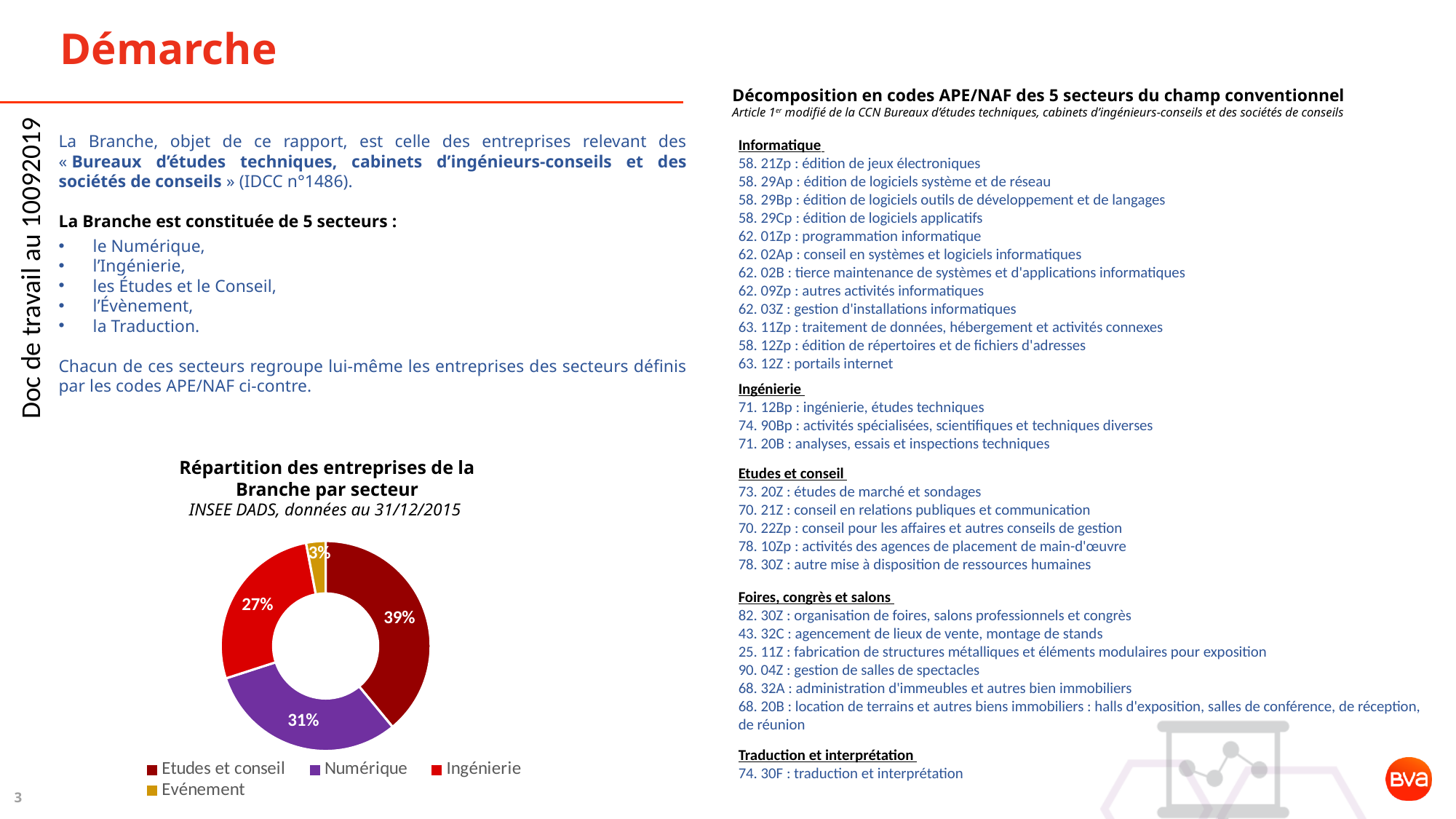
What is the title of the chart? Répartition des entreprises de la Branche par secteur What kind of chart is shown on the slide? Doughnut chart What share of the chart does Numérique represent? 31% What data source is cited under the chart title? INSEE DADS, données au 31/12/2015 What share of the chart does Evénement represent? 3% Which sector has the largest share in the chart? Etudes et conseil What is the difference in percentage points between Etudes et conseil and Ingénierie? 12 How many sectors are shown in the chart? 4 What share of the chart does Etudes et conseil represent? 39% What share of the chart does Ingénierie represent? 27% Which sector has the smallest share in the chart? Evénement Which is larger, the share for Numérique or the share for Ingénierie? Numérique